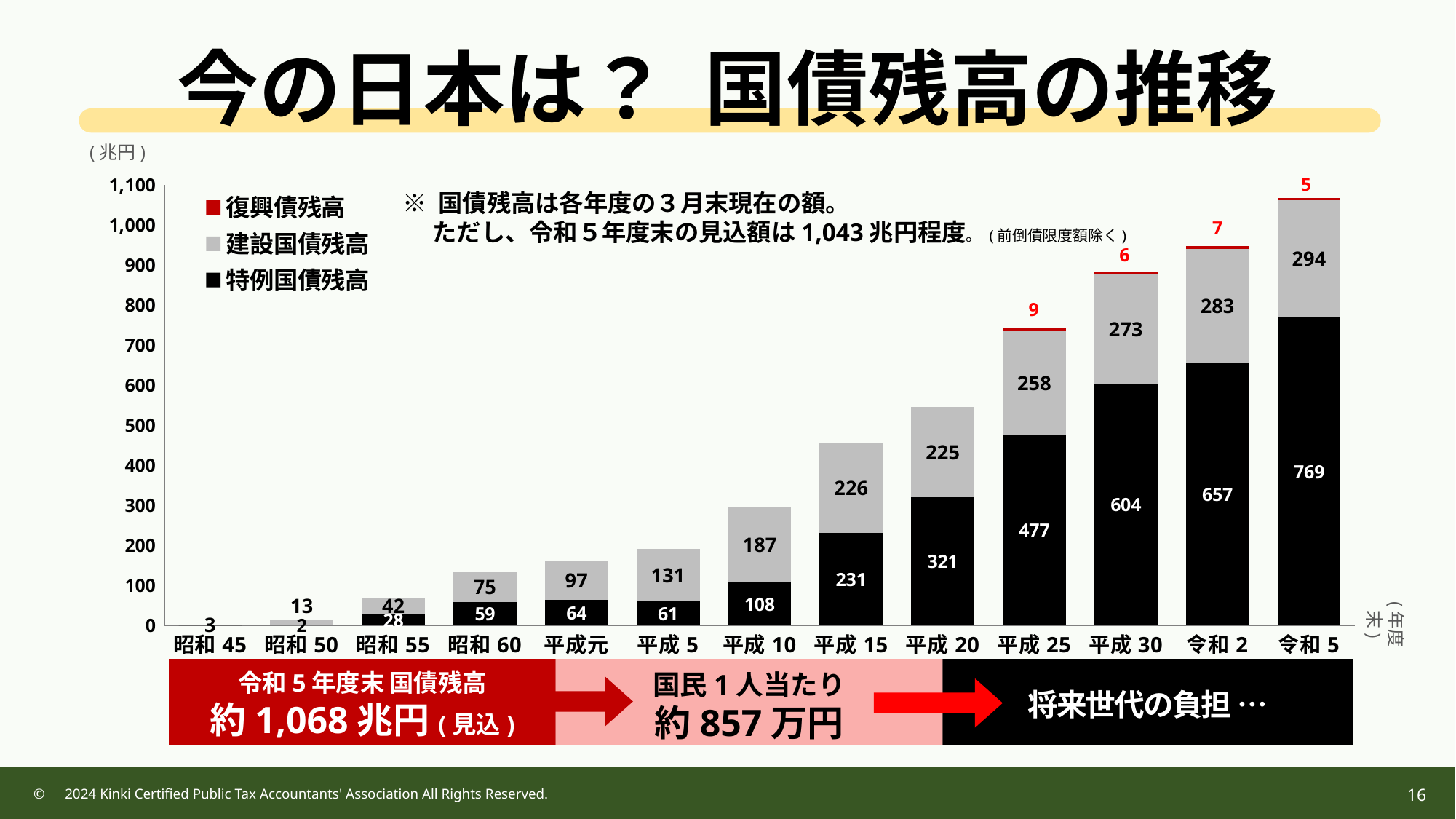
What is the total of the stacked bar for 令和5? 1,068 Is 建設国債残高 larger for 平成15 or for 平成20? 平成15 What is the difference between 特例国債残高 for 令和5 and for 令和2? 112 Do the total bar heights rise or fall from 昭和45 to 令和5? rise What is the value of 建設国債残高 for 平成30? 273 Which fiscal year has the highest 特例国債残高? 令和5 What is the value of 復興債残高 for 平成25? 9 What is the total of the stacked bar for 令和2? 947 How many series does the legend list? 3 What kind of chart is shown on the slide? stacked bar chart What is the value of 特例国債残高 for 令和5? 769 How many fiscal-year categories are plotted along the x axis? 13